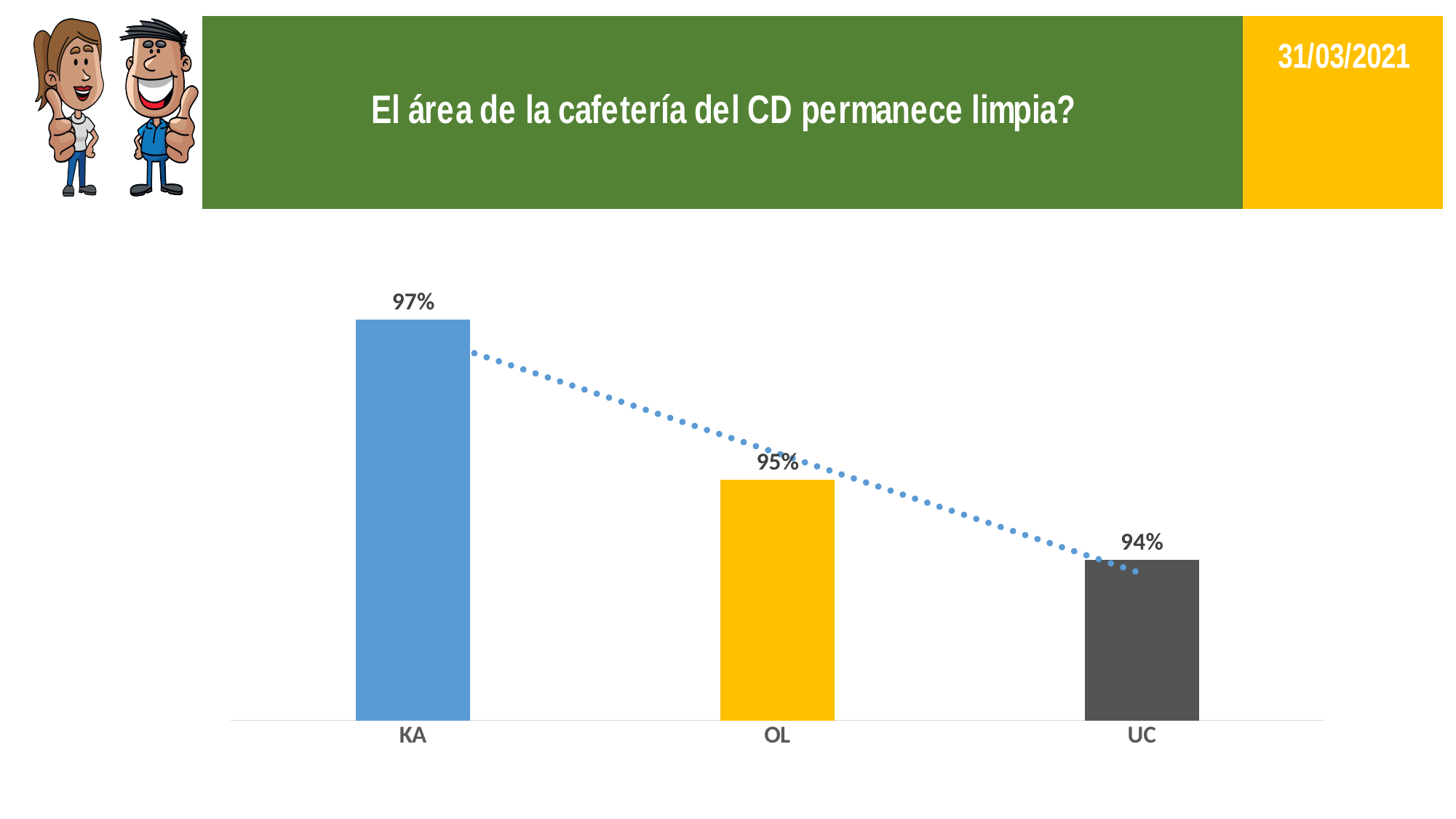
What is the value for OL? 95% Which category has the lowest value? UC What colour is the bar for OL? Yellow Which category has the highest value? KA Which is larger, the value for OL or the value for UC? OL How many categories are shown on the x axis? 3 What is the difference between the values for KA and OL? 2% What is the difference between the values for KA and UC? 3% Do the values rise or fall from KA to UC along the x axis? Fall What kind of chart is shown on the slide? Bar chart What is the value for KA? 97% What is the value for UC? 94%